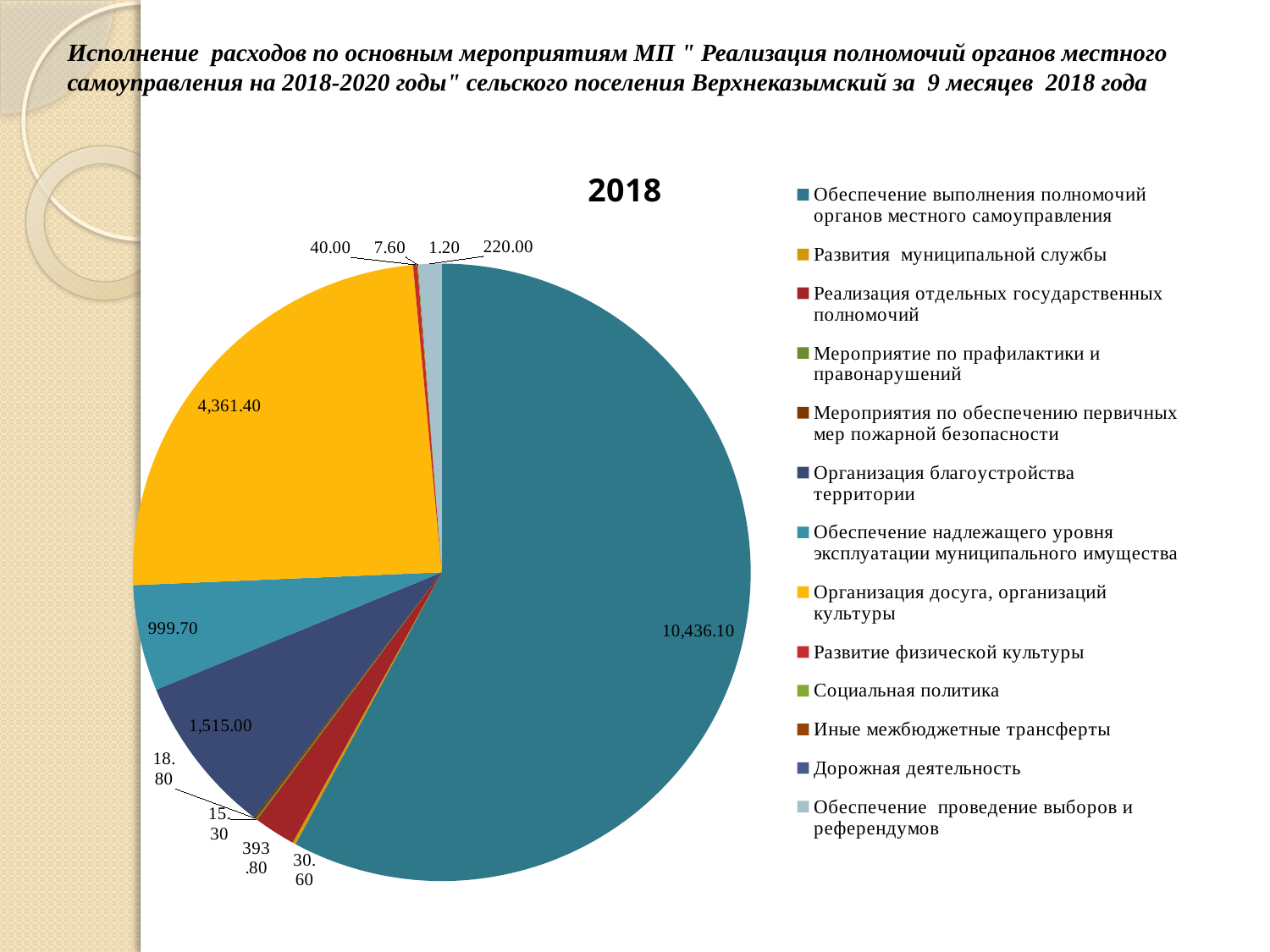
What is the difference between the largest slice (10,436.10) and the large yellow slice (4,361.40)? 6,074.70 What is the difference between the slices labelled 1,515.00 and 999.70? 515.30 What is the title of the chart? 2018 What is the value of the largest slice in the pie chart? 10,436.10 What is the value of the large yellow slice in the pie chart? 4,361.40 Which is larger, the slice labelled 1,515.00 or the slice labelled 999.70? 1,515.00 What is the value for Обеспечение проведение выборов и референдумов? 220.00 How many entries does the chart legend list? 13 What type of chart is shown on the slide? pie chart How many data labels are printed on the pie chart? 12 What is the smallest value labelled on the pie chart? 1.20 What is the value for Обеспечение выполнения полномочий органов местного самоуправления? 10,436.10